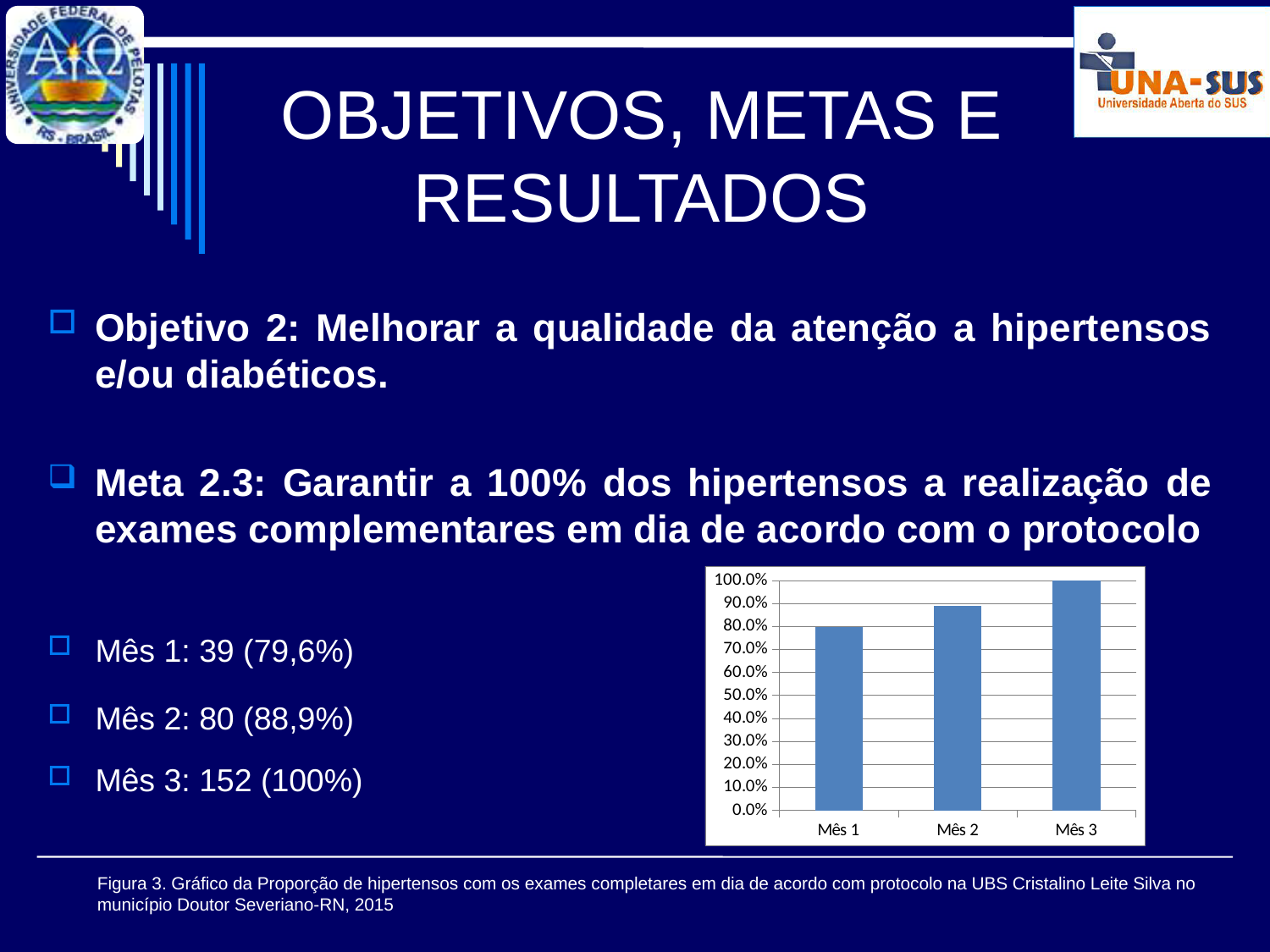
Is the value for Mês 2 greater or less than 90.0%? less What value does the bar for Mês 3 reach on the y axis? 100.0% What colour are the bars in the chart? blue How many categories are plotted on the x axis of the chart? 3 What kind of chart is shown on the slide? bar chart What is the highest tick label shown on the y axis of the chart? 100.0% Which month has the lowest bar in the chart? Mês 1 Is the value for Mês 2 greater or less than 80.0%? greater Do the values rise or fall from Mês 1 to Mês 3? rise Which month has the highest bar in the chart? Mês 3 Is the value for Mês 1 greater or less than 70.0%? greater Which is larger, the bar for Mês 1 or the bar for Mês 2? Mês 2